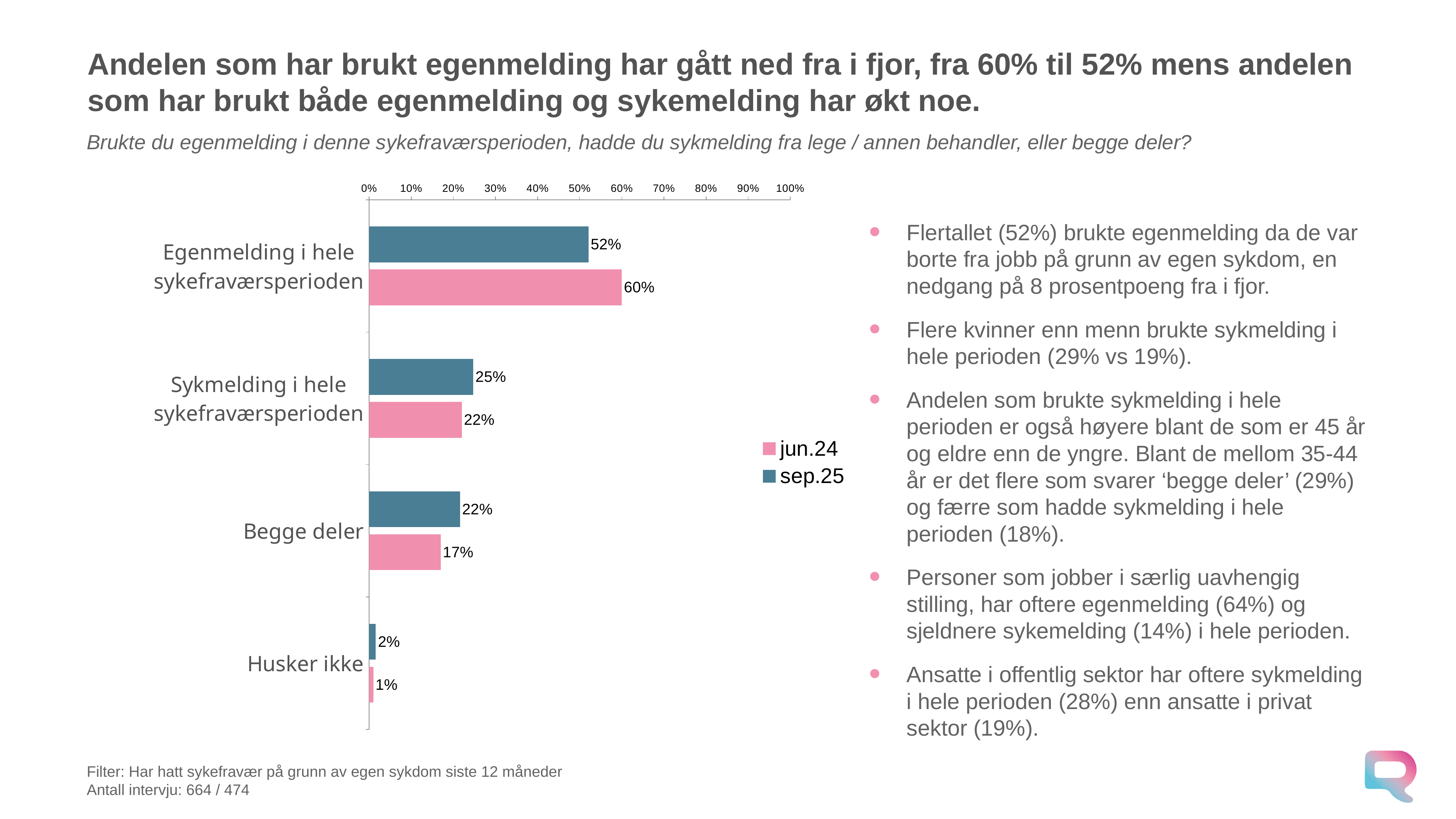
What kind of chart is shown on the slide? Bar chart What is the sep.25 value for 'Sykmelding i hele sykefraværsperioden'? 25% What is the sep.25 value for 'Egenmelding i hele sykefraværsperioden'? 52% How many categories are shown on the chart? 4 Which series is shown in pink in the legend? jun.24 Which category has the highest jun.24 value? Egenmelding i hele sykefraværsperioden Which is larger for 'Begge deler': the jun.24 value or the sep.25 value? sep.25 How many series does the legend list? 2 What is the difference between the sep.25 and jun.24 values for 'Sykmelding i hele sykefraværsperioden'? 3 percentage points What is the jun.24 value for 'Begge deler'? 17% What is the difference between the jun.24 and sep.25 values for 'Egenmelding i hele sykefraværsperioden'? 8 percentage points Which category has the lowest sep.25 value? Husker ikke